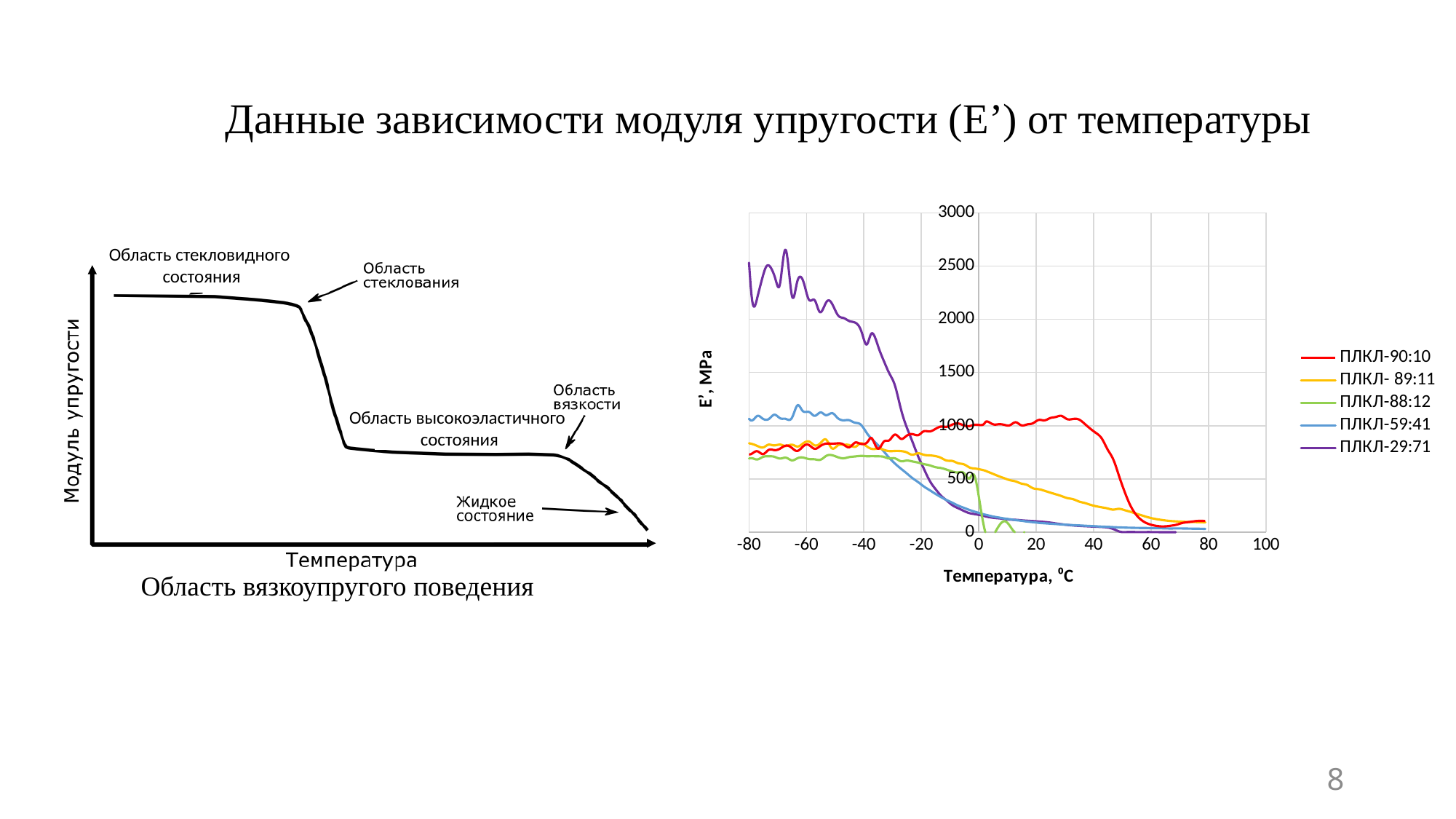
In the right-hand chart, what is the label of the vertical axis? E', MPa In the right-hand chart, which series has the highest value at 20 °C? ПЛКЛ-90:10 In the right-hand chart, is the value for ПЛКЛ-59:41 at 0 °C greater or less than 500? less In the right-hand chart, is the value for ПЛКЛ-90:10 at 0 °C greater or less than 500? greater In the right-hand chart, is the value for ПЛКЛ- 89:11 at 40 °C greater or less than 500? less In the right-hand chart, does the value for ПЛКЛ-29:71 rise or fall as temperature increases from -80 °C to 60 °C? fall How many series does the legend of the right-hand chart list? 5 What kind of chart is the chart on the right of the slide? line chart In the right-hand chart, at -60 °C, which is larger: the value for ПЛКЛ-59:41 or for ПЛКЛ-88:12? ПЛКЛ-59:41 In the right-hand chart, what is the label of the horizontal axis? Температура, ⁰C In the right-hand chart, which series has the highest value at -80 °C? ПЛКЛ-29:71